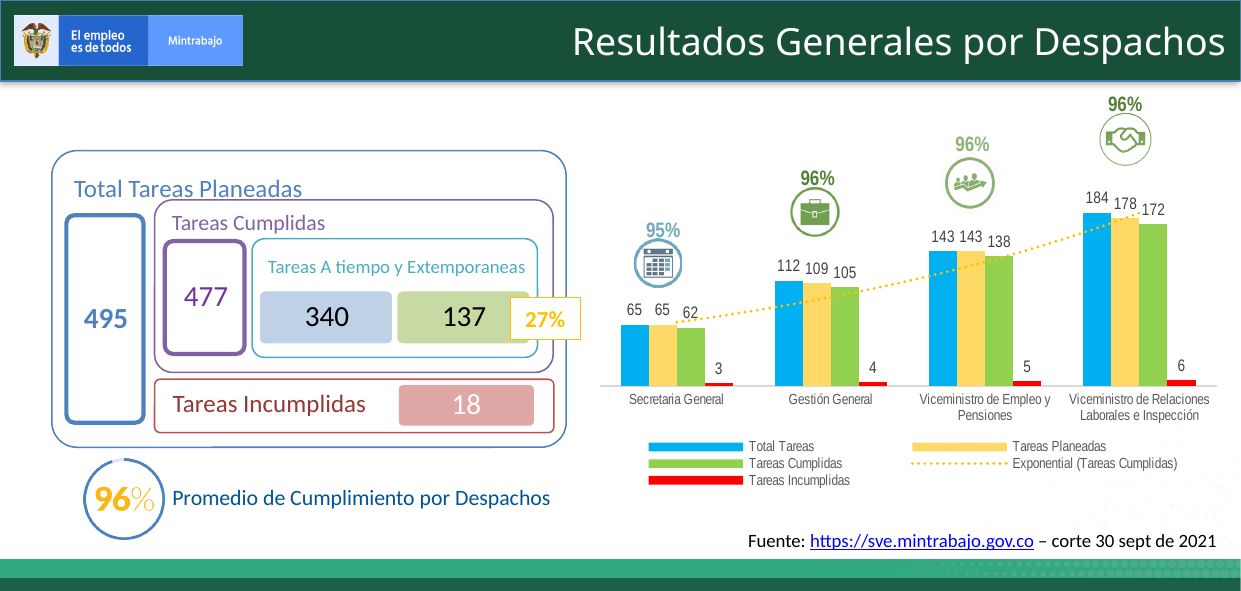
Which category has the lowest Tareas Cumplidas value? Secretaria General Do the Tareas Incumplidas values rise or fall from left to right across the categories? Rise How many entries does the chart legend list? 5 What is the Total Tareas value for Secretaria General? 65 What is the difference between Tareas Planeadas and Tareas Cumplidas for Viceministro de Relaciones Laborales e Inspección? 6 Which category has the highest Total Tareas value? Viceministro de Relaciones Laborales e Inspección What is the Tareas Incumplidas value for Viceministro de Relaciones Laborales e Inspección? 6 What is the Tareas Planeadas value for Viceministro de Empleo y Pensiones? 143 What kind of chart is shown on the right side of the slide? Bar chart Which is larger: Total Tareas for Gestión General or Tareas Cumplidas for Viceministro de Empleo y Pensiones? Tareas Cumplidas for Viceministro de Empleo y Pensiones What is the Tareas Cumplidas value for Gestión General? 105 How many categories are shown on the x axis of the bar chart? 4